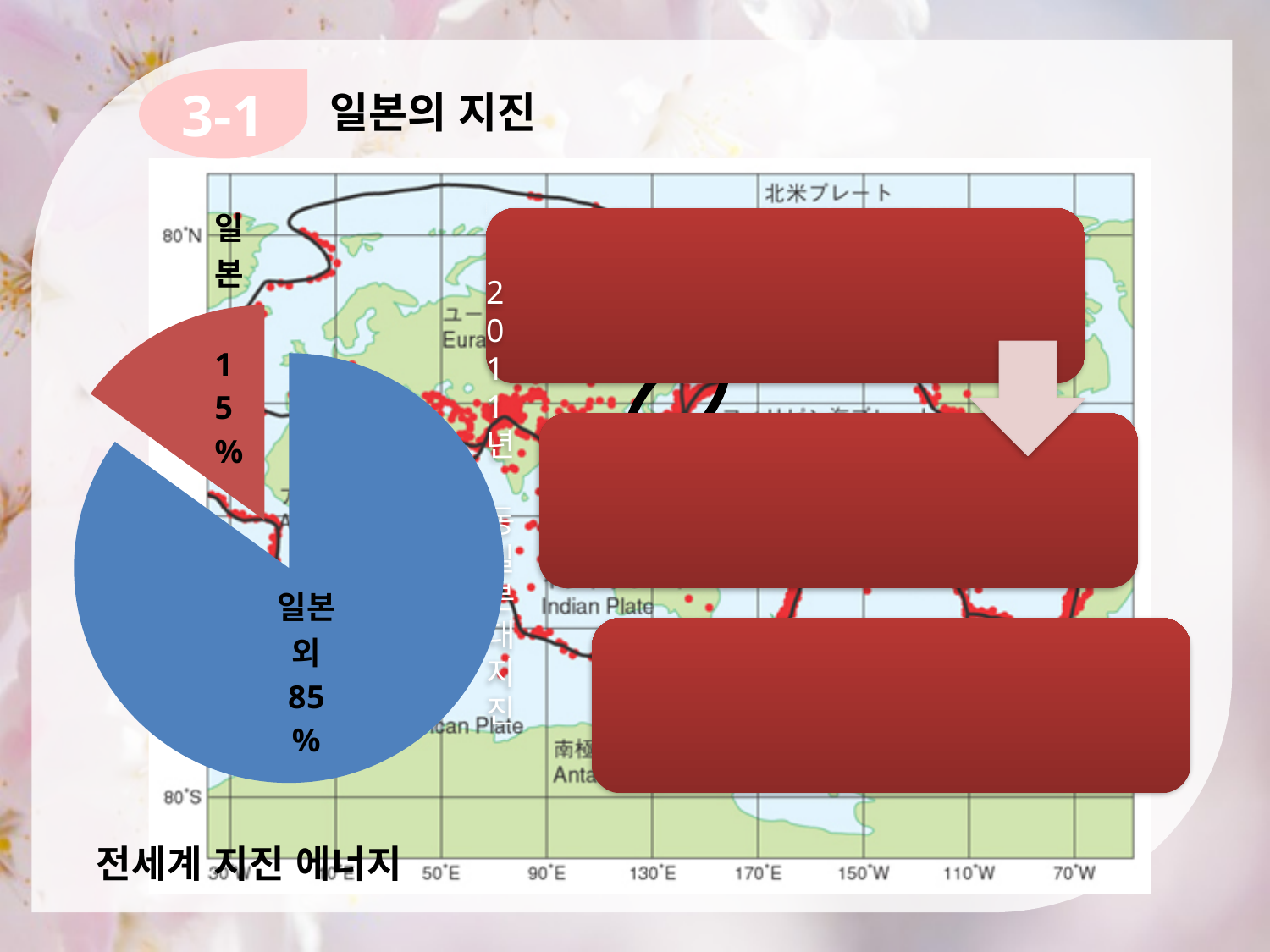
Which slice of the pie is the smallest? 일본 How many slices does the pie chart have? 2 What is the difference in percentage points between the 일본 외 slice and the 일본 slice? 70 What share of the pie does 일본 외 account for? 85% What kind of chart is shown on the slide? pie chart Which is larger, the 일본 slice or the 일본 외 slice? 일본 외 Which slice of the pie is the largest? 일본 외 What is the title shown beneath the pie chart? 전세계 지진 에너지 What colour is the 일본 slice of the pie chart? red What share of the pie does 일본 account for? 15%